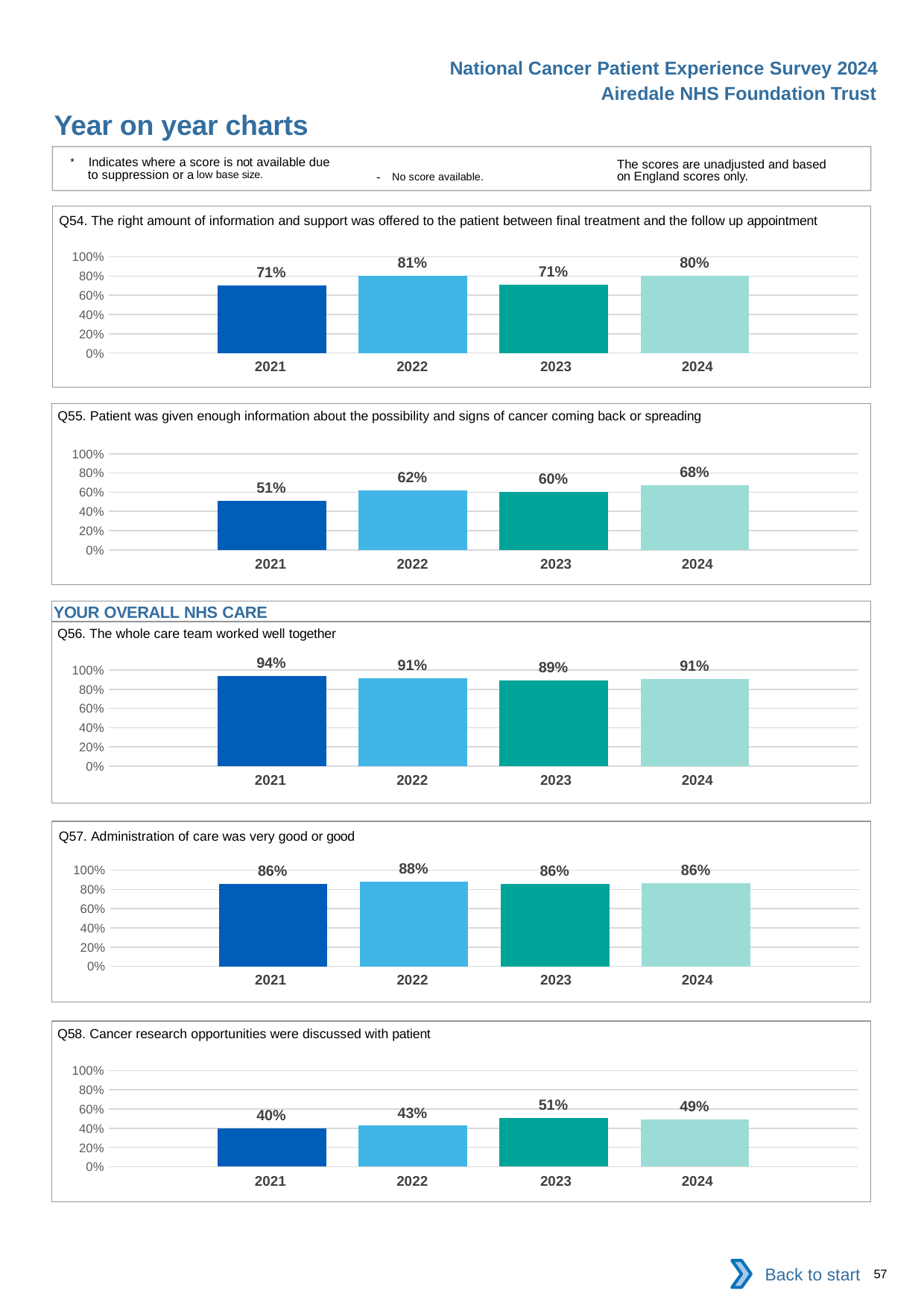
In the Q54 chart, what is the value for 2022? 81% In the Q58 chart, which year has the highest value? 2023 In the Q57 chart, what is the value for 2024? 86% In the Q57 chart, which is larger, the value for 2022 or the value for 2023? 2022 What kind of chart is the Q58 chart? bar chart In the Q55 chart, which year has the lowest value? 2021 How many years are shown in the Q54 chart? 4 In the Q58 chart, is the value for 2021 greater or less than 60%? less In the Q55 chart, what is the difference between the 2024 and 2021 values? 17 percentage points In the Q54 chart, what is the difference between the 2022 and 2023 values? 10 percentage points In the Q56 chart, which year has the highest value? 2021 In the Q56 chart, what is the value for 2023? 89%